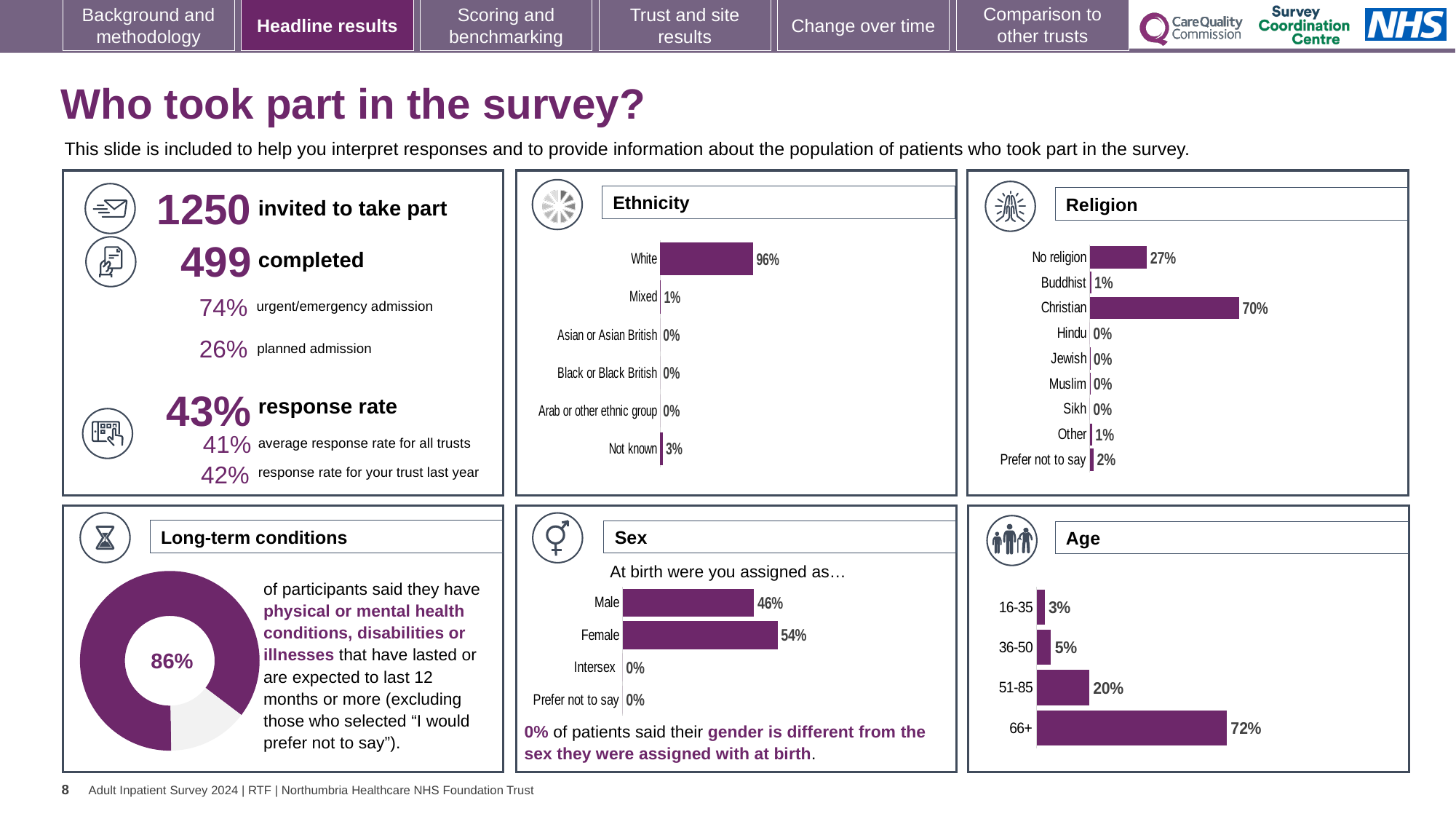
How many categories does the Religion chart show? 9 In the Age chart, what is the difference between the 66+ and 51-85 values? 52% In the Ethnicity chart, what is the value for Not known? 3% How many categories does the Age chart show? 4 In the Ethnicity chart, what percentage of respondents were White? 96% In the Sex chart, which is larger, Male or Female? Female In the Religion chart, what is the value for No religion? 27% What kind of chart is the Long-term conditions chart? Doughnut chart In the Sex chart, what is the value for Male? 46% In the Long-term conditions chart, what share of participants said they have long-term conditions? 86% In the Age chart, do the values rise or fall from 16-35 to 66+? Rise In the Religion chart, which category has the highest value? Christian